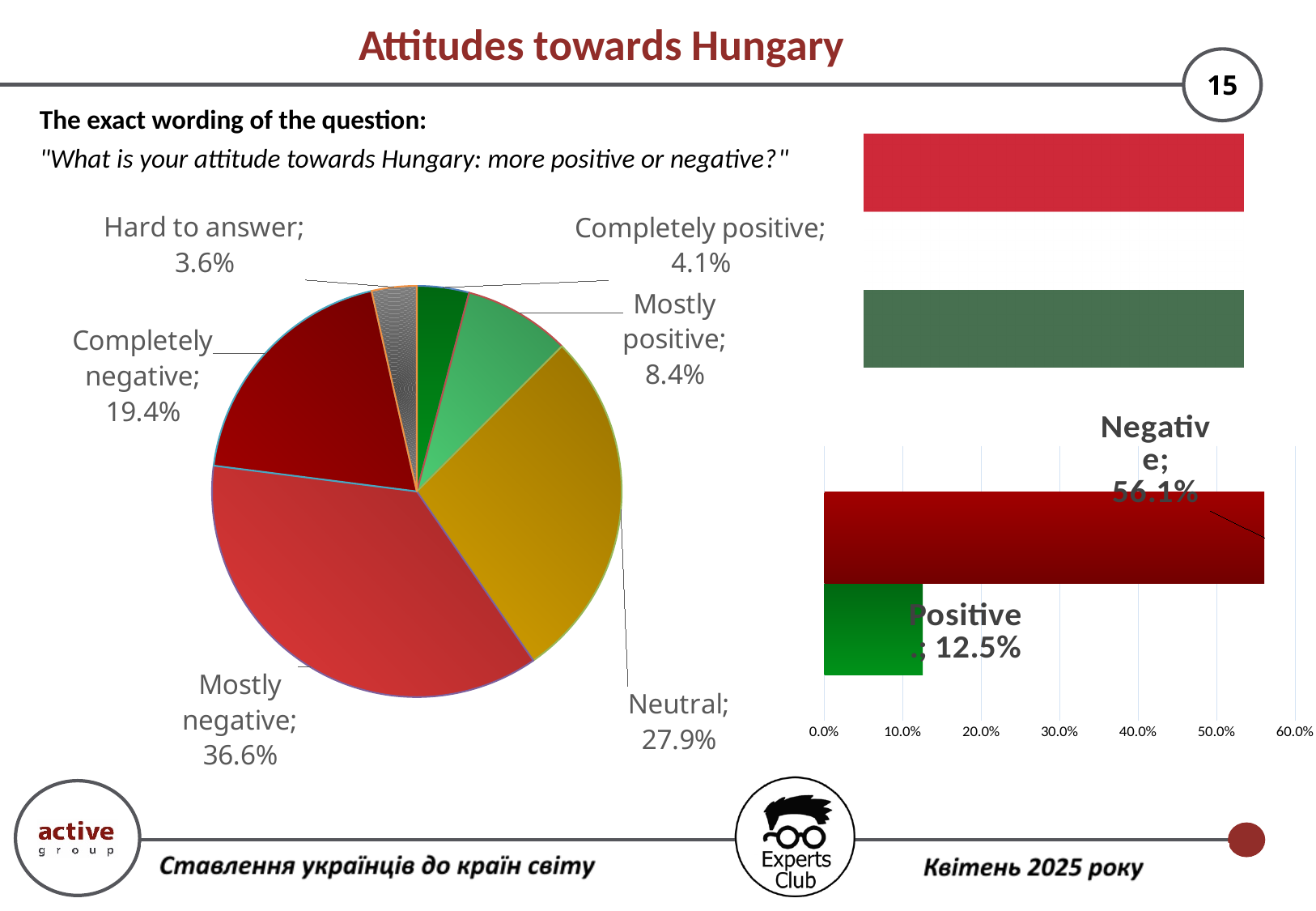
What type of chart is shown on the right side of the slide? Bar chart In the pie chart, what share of respondents answered 'Completely positive'? 4.1% In the bar chart on the right, what is the value for 'Positive'? 12.5% In the pie chart, what share of respondents answered 'Neutral'? 27.9% In the pie chart, which category has the smallest share? Hard to answer In the pie chart, which category has the largest share? Mostly negative In the pie chart, what share of respondents answered 'Mostly negative'? 36.6% In the bar chart on the right, what is the value for 'Negative'? 56.1% In the pie chart, what is the difference between 'Completely negative' and 'Mostly positive'? 11.0% In the pie chart, how many categories are shown? 6 In the pie chart, which is larger: 'Mostly positive' or 'Completely positive'? Mostly positive In the bar chart on the right, what is the difference between 'Negative' and 'Positive'? 43.6%